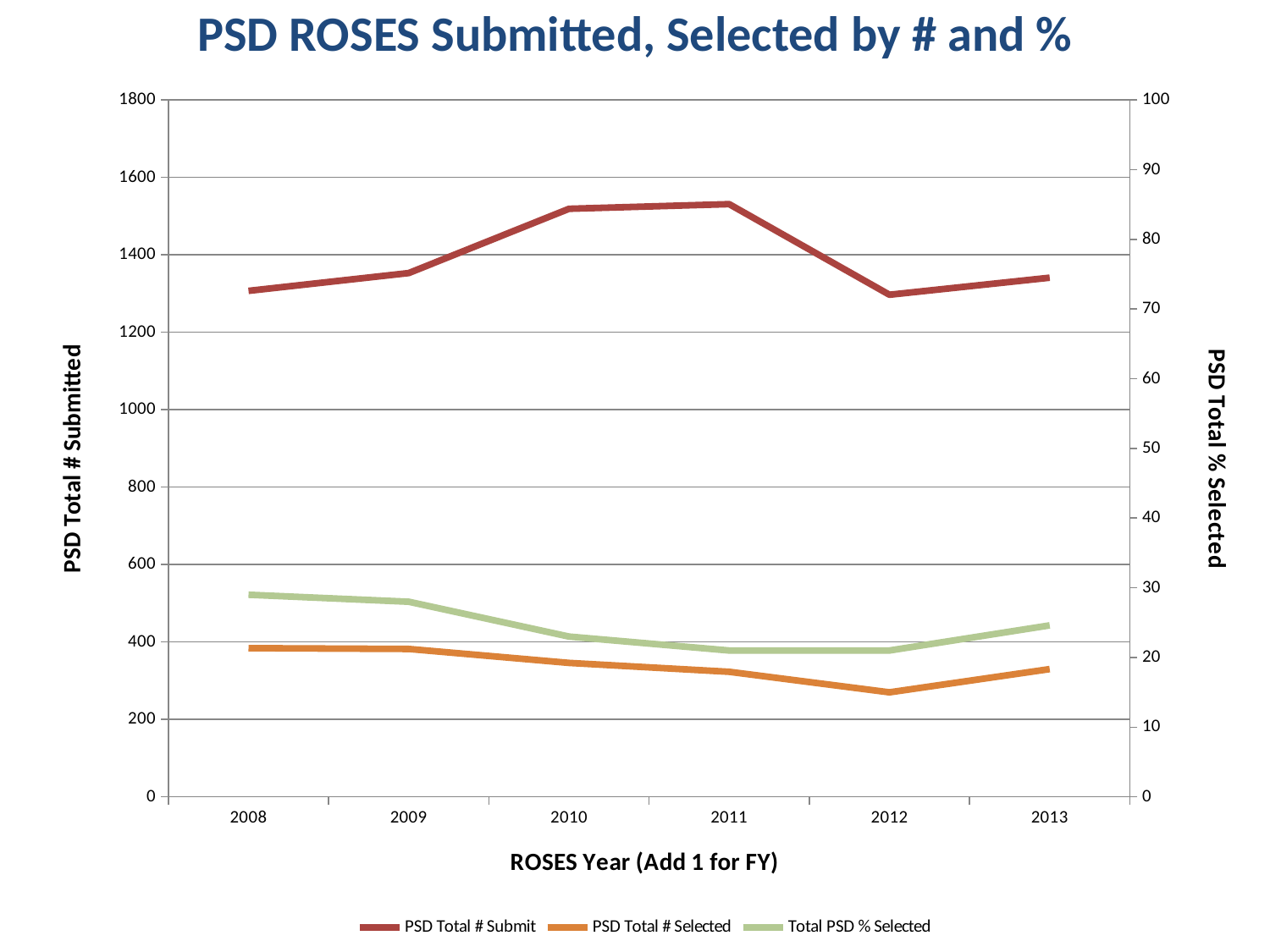
Is the value for Total PSD % Selected in 2008 greater or less than 25 on the right axis? greater Is the value for PSD Total # Submit in 2012 greater or less than 1400? less Which is larger for Total PSD % Selected, the value in 2013 or the value in 2011? 2013 Is the value for PSD Total # Selected in 2012 greater or less than 300? less How many years are plotted along the x axis? 6 What is the label of the x axis? ROSES Year (Add 1 for FY) Which year has the lowest value for PSD Total # Selected? 2012 What kind of chart is shown on the slide? line chart Which is larger for PSD Total # Submit, the value in 2010 or the value in 2008? 2010 How many series does the legend list? 3 Does the PSD Total # Selected line rise or fall from 2008 to 2012? fall